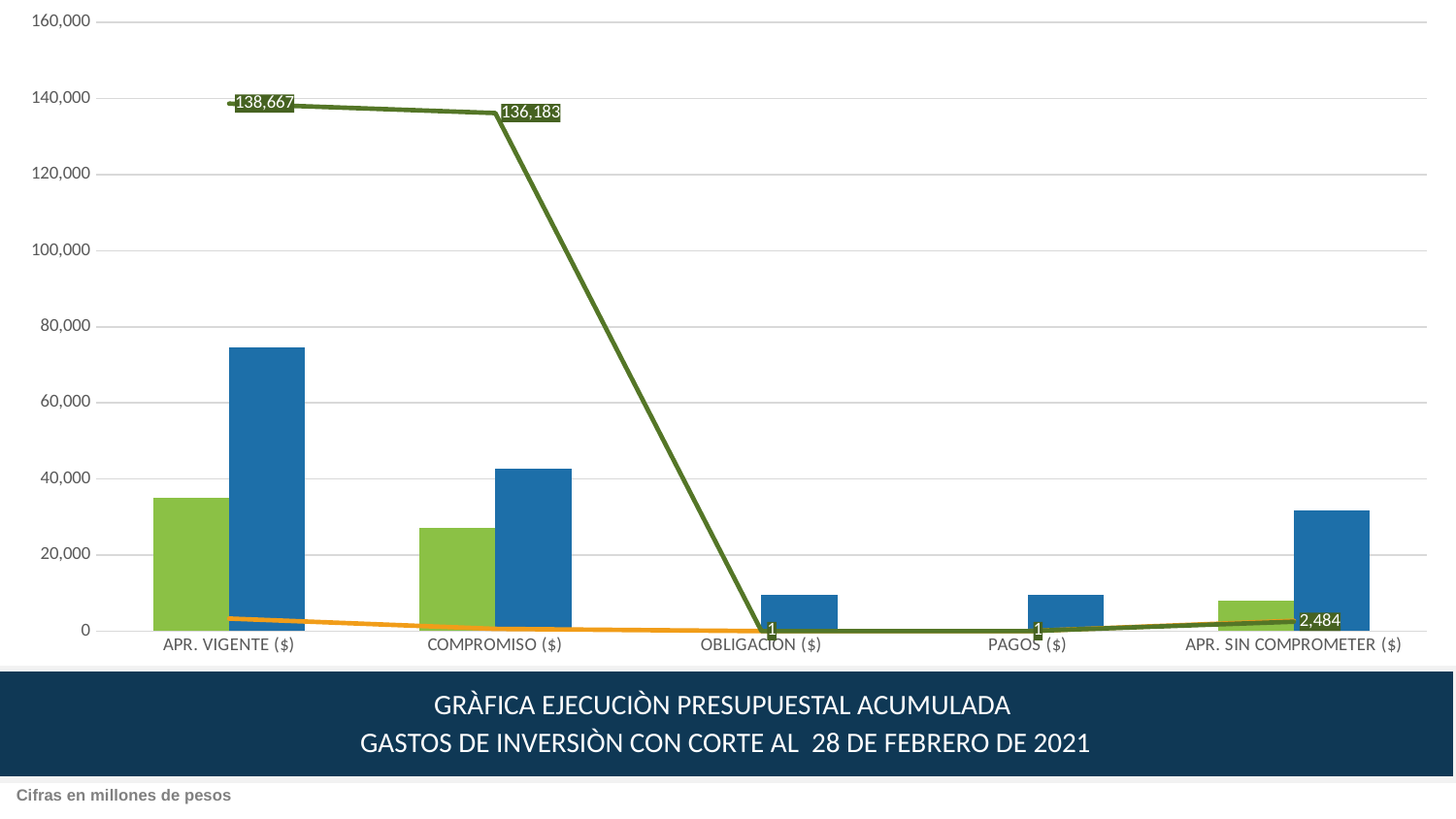
Does the green line rise or fall from COMPROMISO ($) to OBLIGACION ($)? fall Which has the taller blue bar, APR. VIGENTE ($) or COMPROMISO ($)? APR. VIGENTE ($) Is the green bar for COMPROMISO ($) greater or less than 20,000? greater What value does the green line show for APR. VIGENTE ($)? 138,667 How many categories are shown on the x axis of the chart? 5 What value does the green line show for COMPROMISO ($)? 136,183 What kind of chart is shown on the slide? A combined bar and line chart What is the difference between the green line values for APR. VIGENTE ($) and COMPROMISO ($)? 2,484 At which category does the green line reach its highest value? APR. VIGENTE ($) What value does the green line show for OBLIGACION ($)? 1 What value does the green line show for APR. SIN COMPROMETER ($)? 2,484 Is the blue bar for APR. VIGENTE ($) greater or less than 60,000? greater